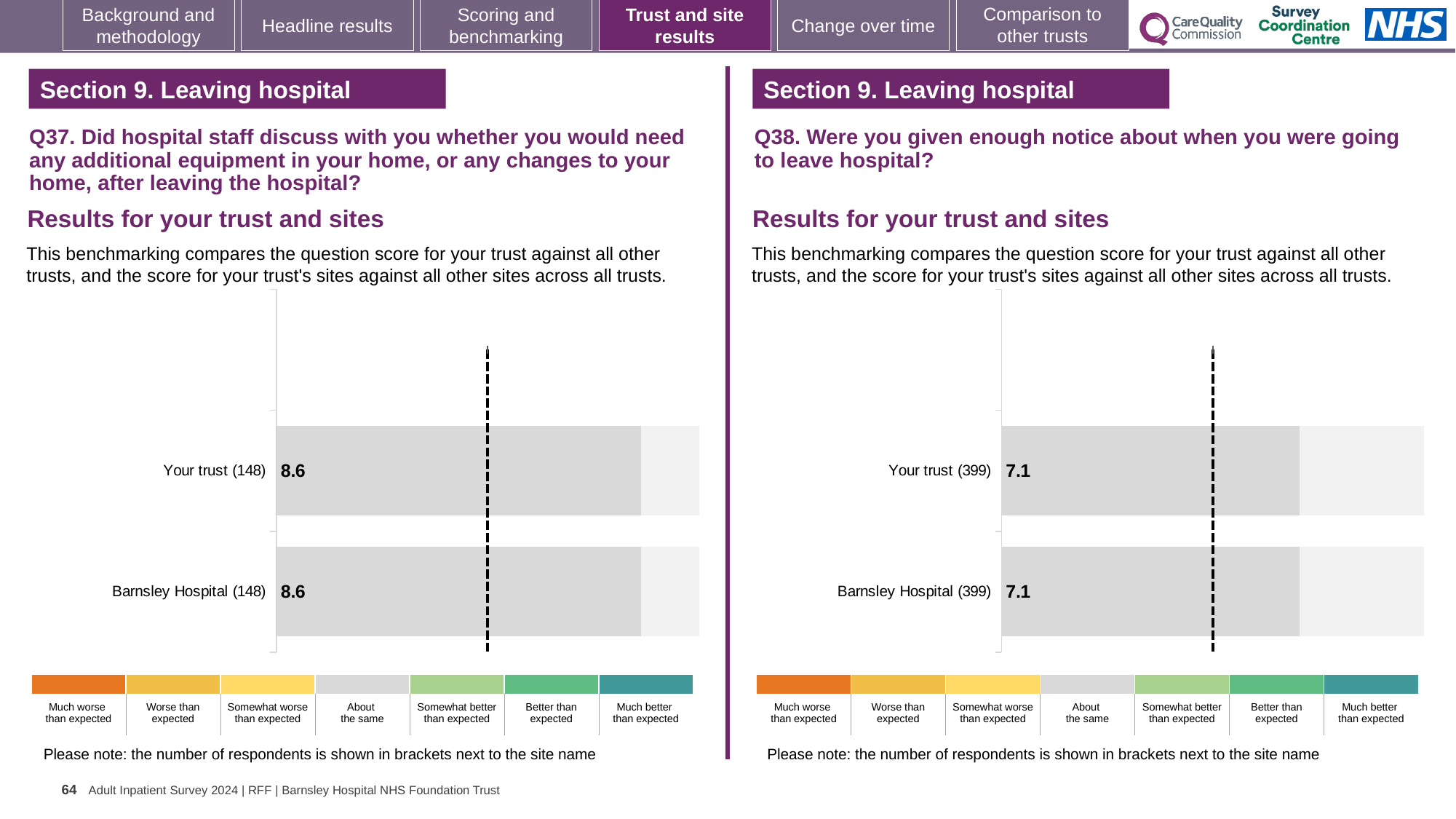
In the Q38 chart on the right, what is the score for Your trust? 7.1 In the Q37 chart on the left, what is the score for Your trust? 8.6 In the Q38 chart on the right, what is the difference between the Your trust score and the Barnsley Hospital score? 0 How many bars are plotted in the Q38 chart on the right? 2 In the Q37 chart on the left, how many respondents are shown in brackets next to Barnsley Hospital? 148 In the Q37 chart on the left, what is the difference between the Your trust score and the Barnsley Hospital score? 0 In the Q38 chart on the right, how many respondents are shown in brackets next to Your trust? 399 How many bars are plotted in the Q37 chart on the left? 2 In the Q37 chart on the left, what is the score for Barnsley Hospital? 8.6 What type of chart is used for the Q38 results on the right? Bar chart In the Q38 chart on the right, what is the score for Barnsley Hospital? 7.1 Is the Your trust score in the Q37 chart on the left larger or smaller than the Your trust score in the Q38 chart on the right? Larger